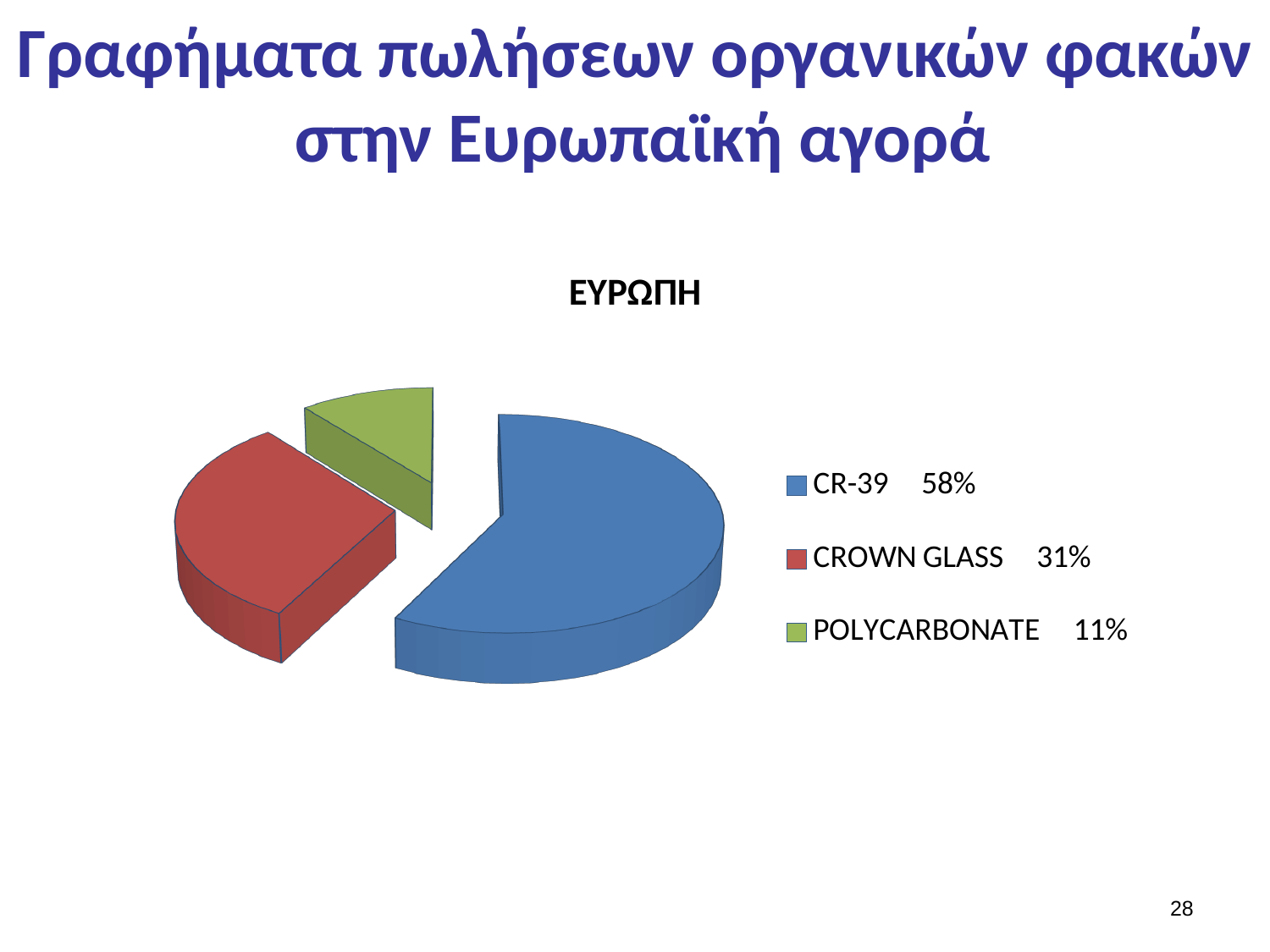
How many categories does the pie chart show? 3 What share of the pie does CROWN GLASS have? 31% What share of the pie does POLYCARBONATE have? 11% What share of the pie does CR-39 have? 58% What kind of chart is shown on the slide? pie chart What is the title of the chart? ΕΥΡΩΠΗ What is the difference in percentage points between CR-39 and CROWN GLASS? 27 Which category has the largest slice of the pie? CR-39 What is the difference in percentage points between CROWN GLASS and POLYCARBONATE? 20 Which is larger, the share for CROWN GLASS or the share for POLYCARBONATE? CROWN GLASS Which category has the smallest slice of the pie? POLYCARBONATE What colour is the slice for CR-39? blue